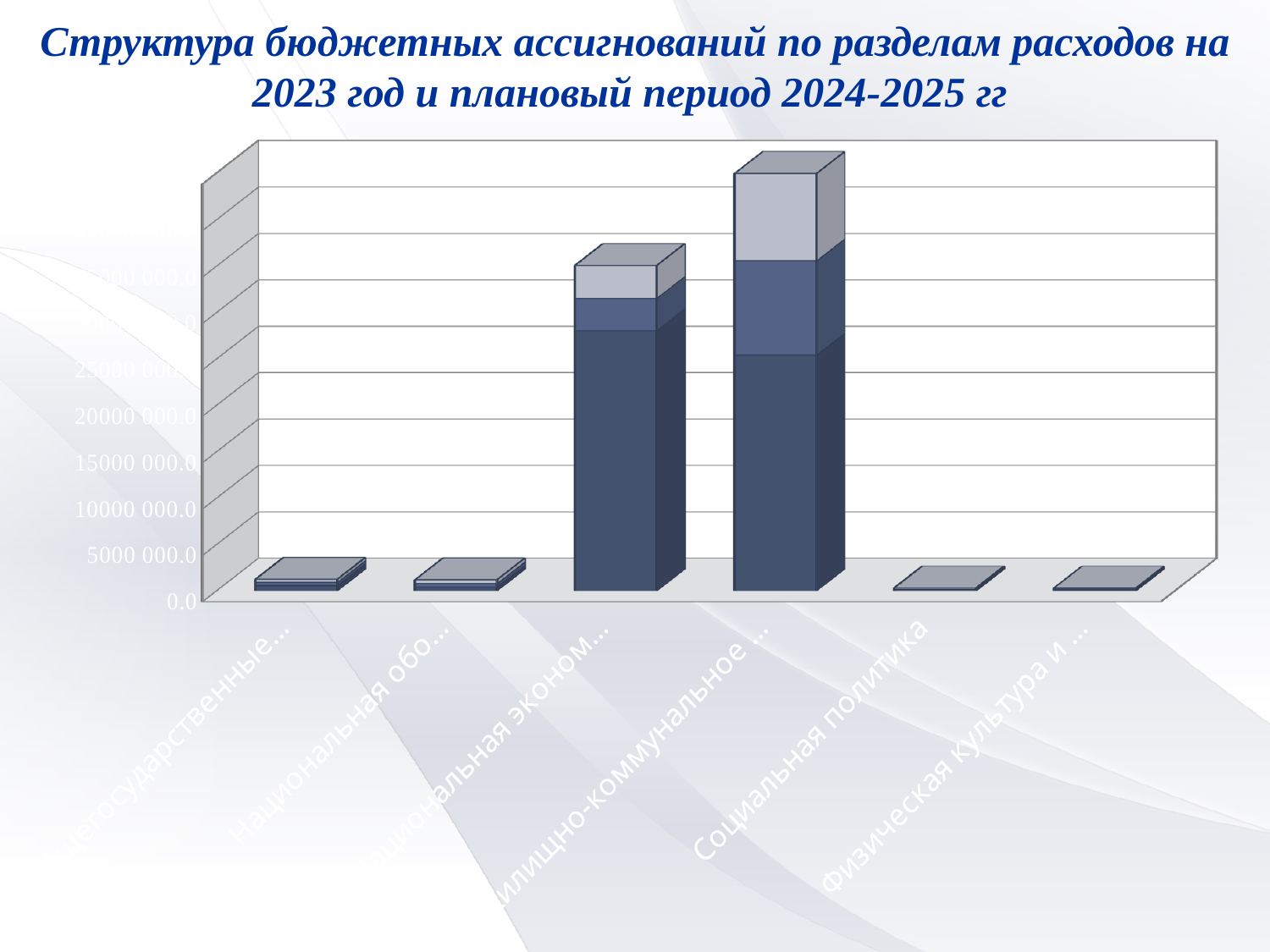
Is the total value for the bar labelled "Жилищно-коммунальное ..." greater or less than 30000 000.0? greater Which category has the tallest stacked bar? Жилищно-коммунальное ... Is the total value for the bar labelled "Национальная эконом..." greater or less than 25000 000.0? greater How many stacked segments make up the tallest bar in the chart? 3 Do the bar heights rise steadily from left to right along the x axis? No What is the title of the slide containing the chart? Структура бюджетных ассигнований по разделам расходов на 2023 год и плановый период 2024-2025 гг Is the value for "Социальная политика" greater or less than 5000 000.0? less Which bar is taller: "Национальная эконом..." or "Жилищно-коммунальное ..."? Жилищно-коммунальное ... What kind of chart is shown on the slide? bar chart How many categories are shown along the x axis of the chart? 6